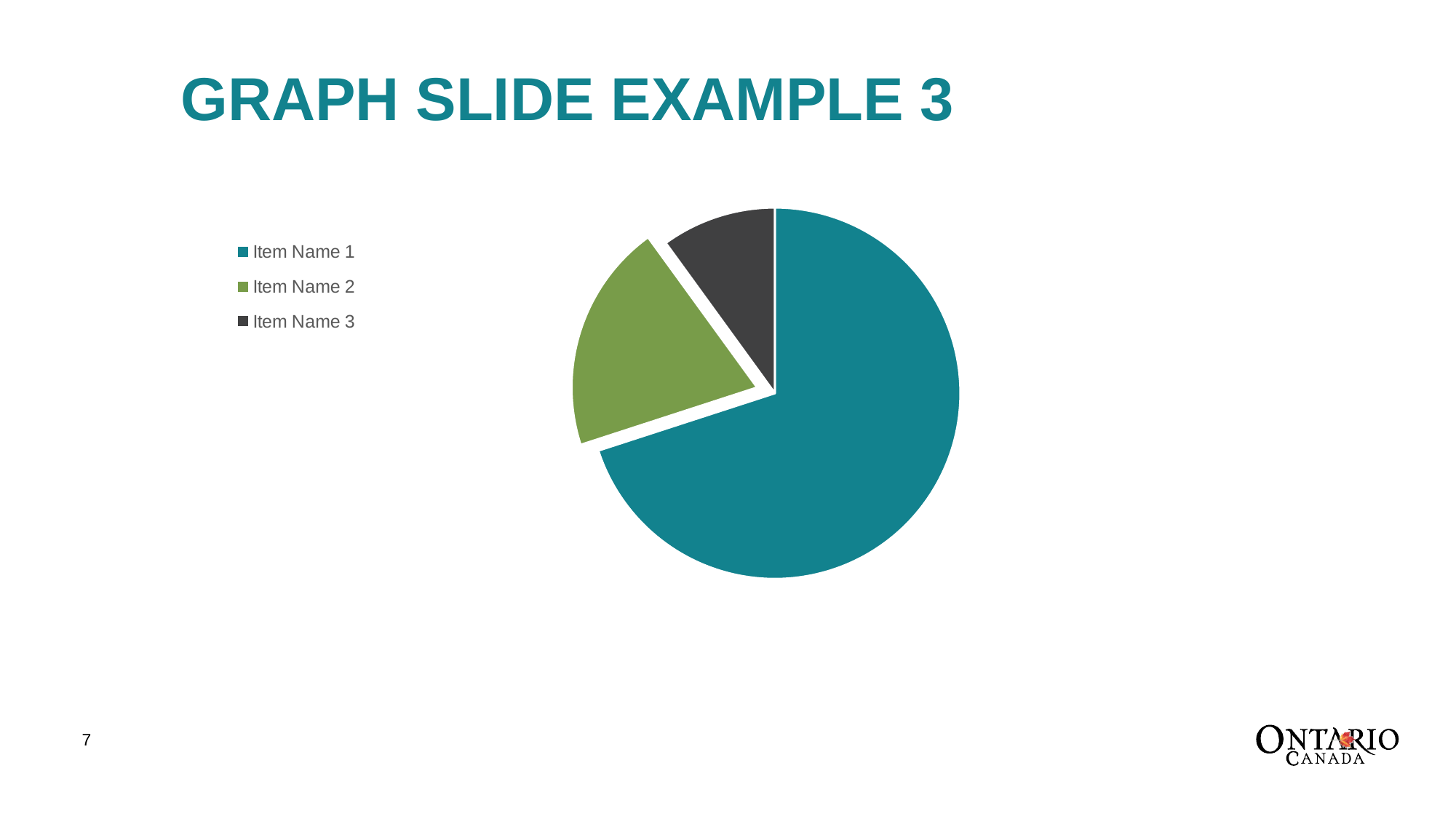
What colour is the slice for Item Name 2 in the pie chart? green Does Item Name 1 take up more or less than half of the pie? more How many slices does the pie chart have? 3 What kind of chart is shown on the slide? pie chart How many entries does the legend of the pie chart list? 3 Which item has the smallest slice in the pie chart? Item Name 3 Which item has the largest slice in the pie chart? Item Name 1 Which slice is larger, Item Name 1 or Item Name 2? Item Name 1 Which legend entry is shown in dark grey? Item Name 3 Which slice is larger, Item Name 2 or Item Name 3? Item Name 2